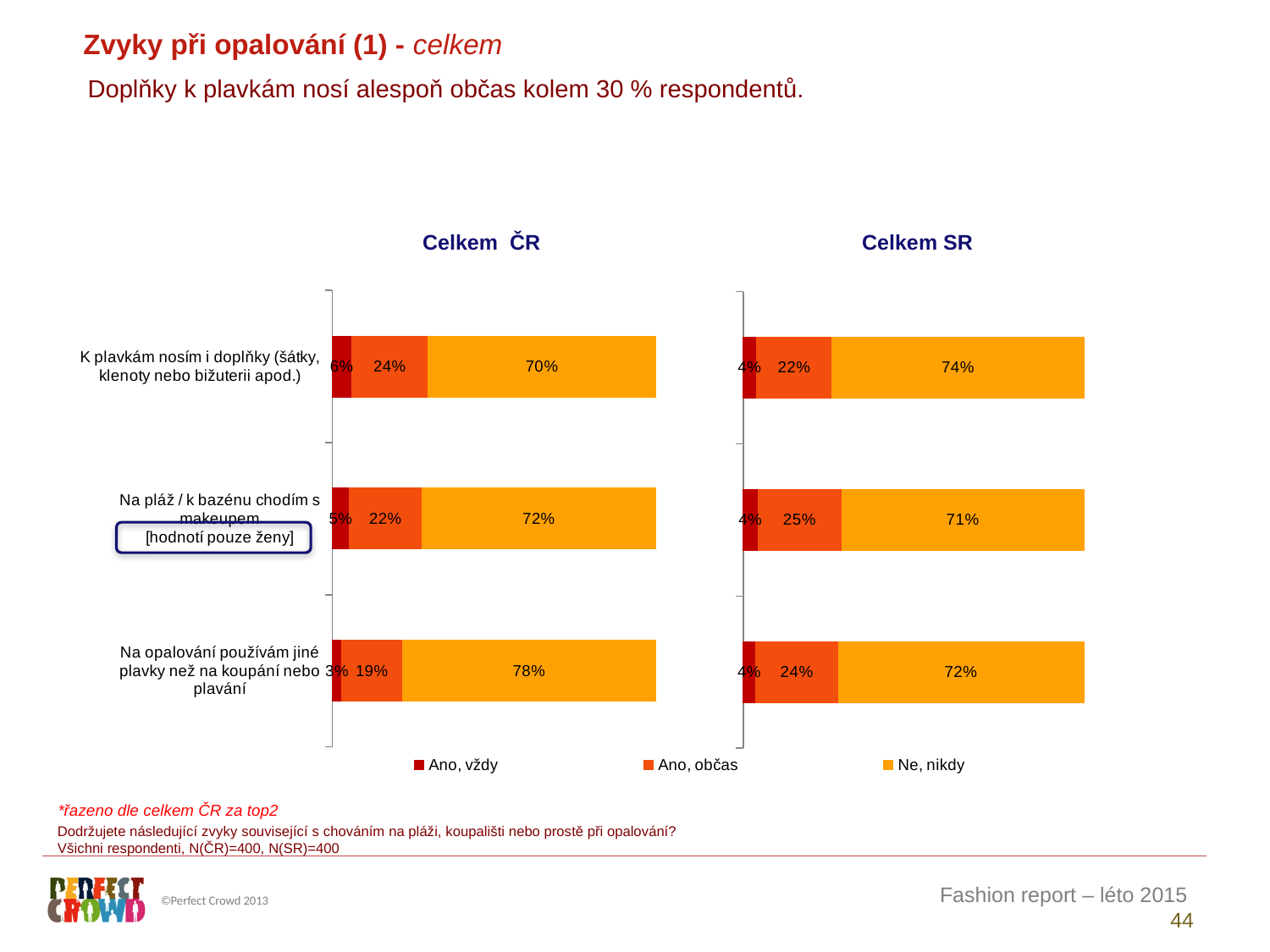
In the Celkem ČR chart, which category has the lowest "Ano, občas" value? Na opalování používám jiné plavky než na koupání nebo plavání What is the difference between the "Ne, nikdy" values for "Na opalování používám jiné plavky než na koupání nebo plavání" in the Celkem ČR chart and the Celkem SR chart? 6% In the Celkem SR chart, what is the value of "Ne, nikdy" for "K plavkám nosím i doplňky (šátky, klenoty nebo bižuterii apod.)"? 74% In the Celkem SR chart, what is the value of "Ano, občas" for "Na pláž / k bazénu chodím s makeupem"? 25% In the Celkem SR chart, which category has the highest "Ano, občas" value? Na pláž / k bazénu chodím s makeupem How many categories are shown in the Celkem ČR chart? 3 In the Celkem ČR chart, what is the value of "Ano, vždy" for "K plavkám nosím i doplňky (šátky, klenoty nebo bižuterii apod.)"? 6% How many series does the legend list? 3 What type of chart is the Celkem SR chart? Stacked bar chart Is the "Ano, občas" value for "K plavkám nosím i doplňky" larger in the Celkem ČR chart or the Celkem SR chart? Celkem ČR In the Celkem ČR chart, which category has the highest "Ne, nikdy" value? Na opalování používám jiné plavky než na koupání nebo plavání In the Celkem ČR chart, what is the value of "Ne, nikdy" for "Na opalování používám jiné plavky než na koupání nebo plavání"? 78%